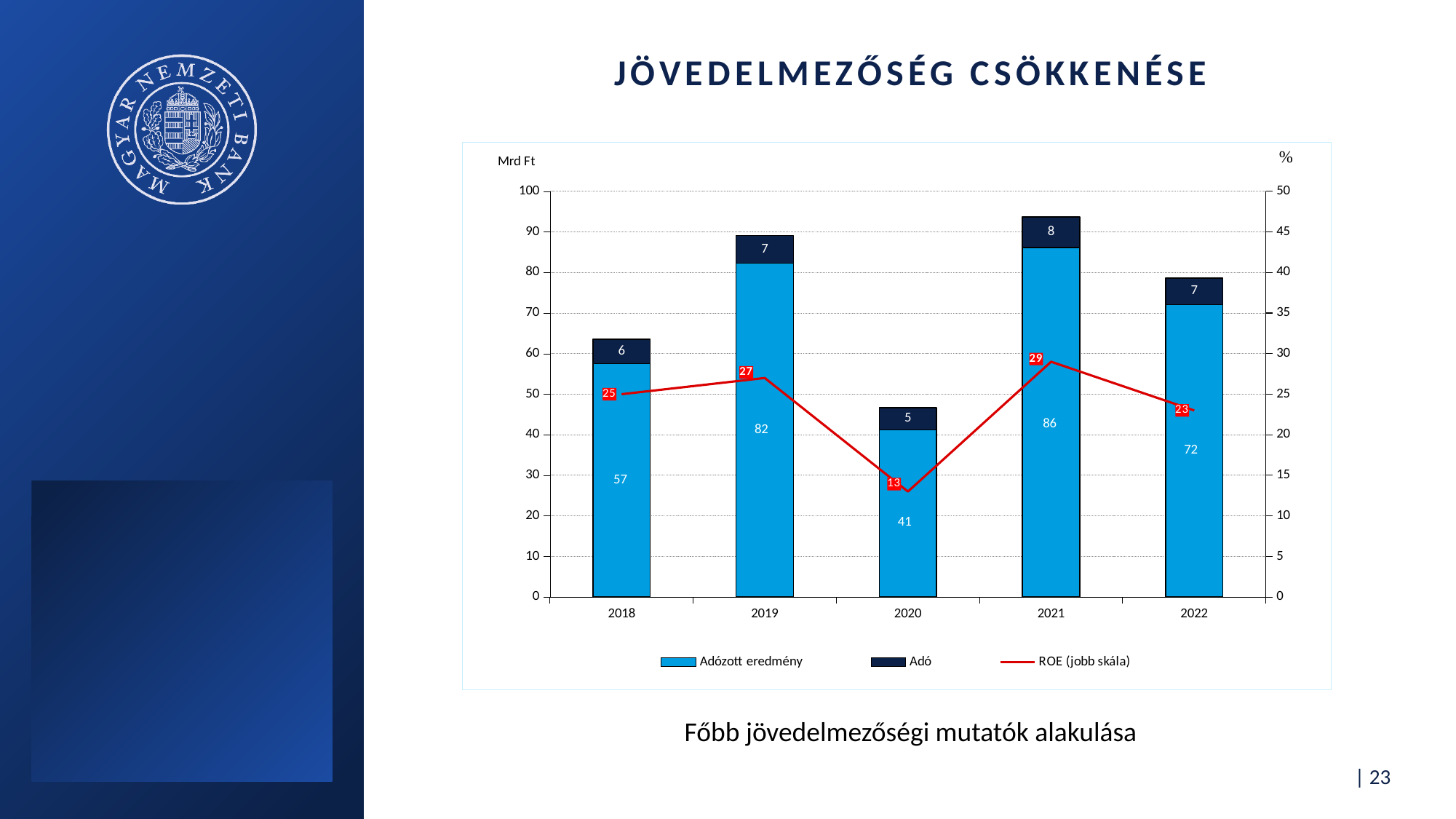
What is the total of the stacked bar for 2019 (Adózott eredmény plus Adó)? 89 What is the value of Adózott eredmény for 2019? 82 In which year is Adózott eredmény the highest? 2021 What is the value of Adó for 2021? 8 What is the difference between Adózott eredmény in 2021 and in 2020? 45 Which is larger, Adózott eredmény in 2018 or in 2022? 2022 What is the ROE (jobb skála) value for 2020? 13 How many series does the legend list? 3 What kind of chart is shown on the slide? Stacked bar chart with a line How many years are shown on the x axis? 5 In which year is ROE (jobb skála) the lowest? 2020 What unit is shown on the left axis of the chart? Mrd Ft